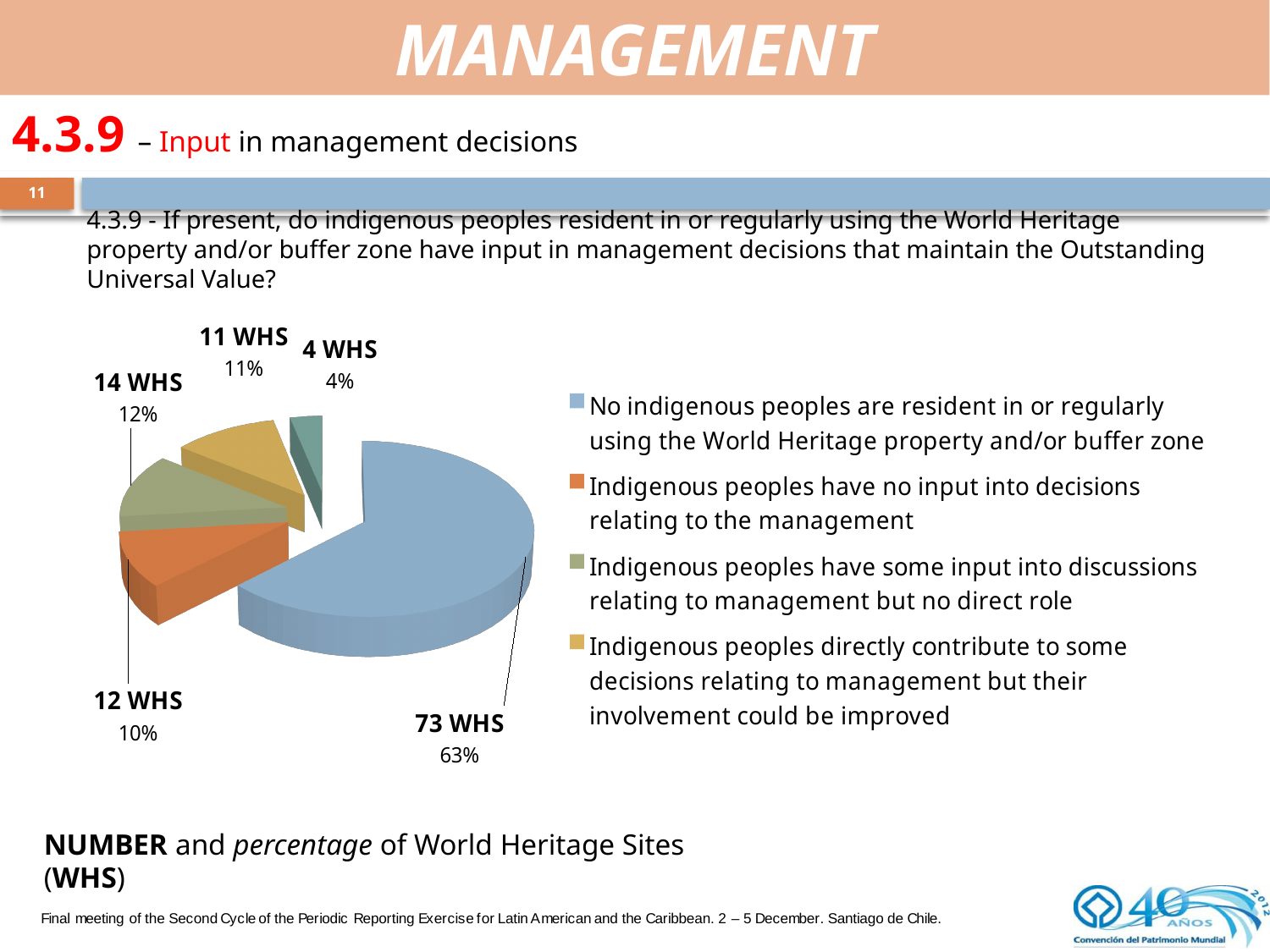
What kind of chart is shown on the slide? pie chart How many WHS are in the smallest slice of the pie chart? 4 WHS How many WHS are in the largest slice of the pie chart? 73 WHS How many WHS are in the slice for 'Indigenous peoples directly contribute to some decisions relating to management but their involvement could be improved'? 11 WHS What percentage of WHS is in the slice for 'Indigenous peoples have some input into discussions relating to management but no direct role'? 12% What percentage share does the largest slice (73 WHS) have? 63% How many WHS are in the slice for 'Indigenous peoples have no input into decisions relating to the management'? 12 WHS Which slice has more WHS: the one for 'some input into discussions' or the one for 'directly contribute to some decisions'? some input into discussions (14 WHS) How many slices does the pie chart have? 5 What is the total number of WHS across all slices of the pie chart? 114 WHS What is the difference in number of WHS between the 73 WHS slice and the 12 WHS slice? 61 WHS How many entries does the legend list? 4